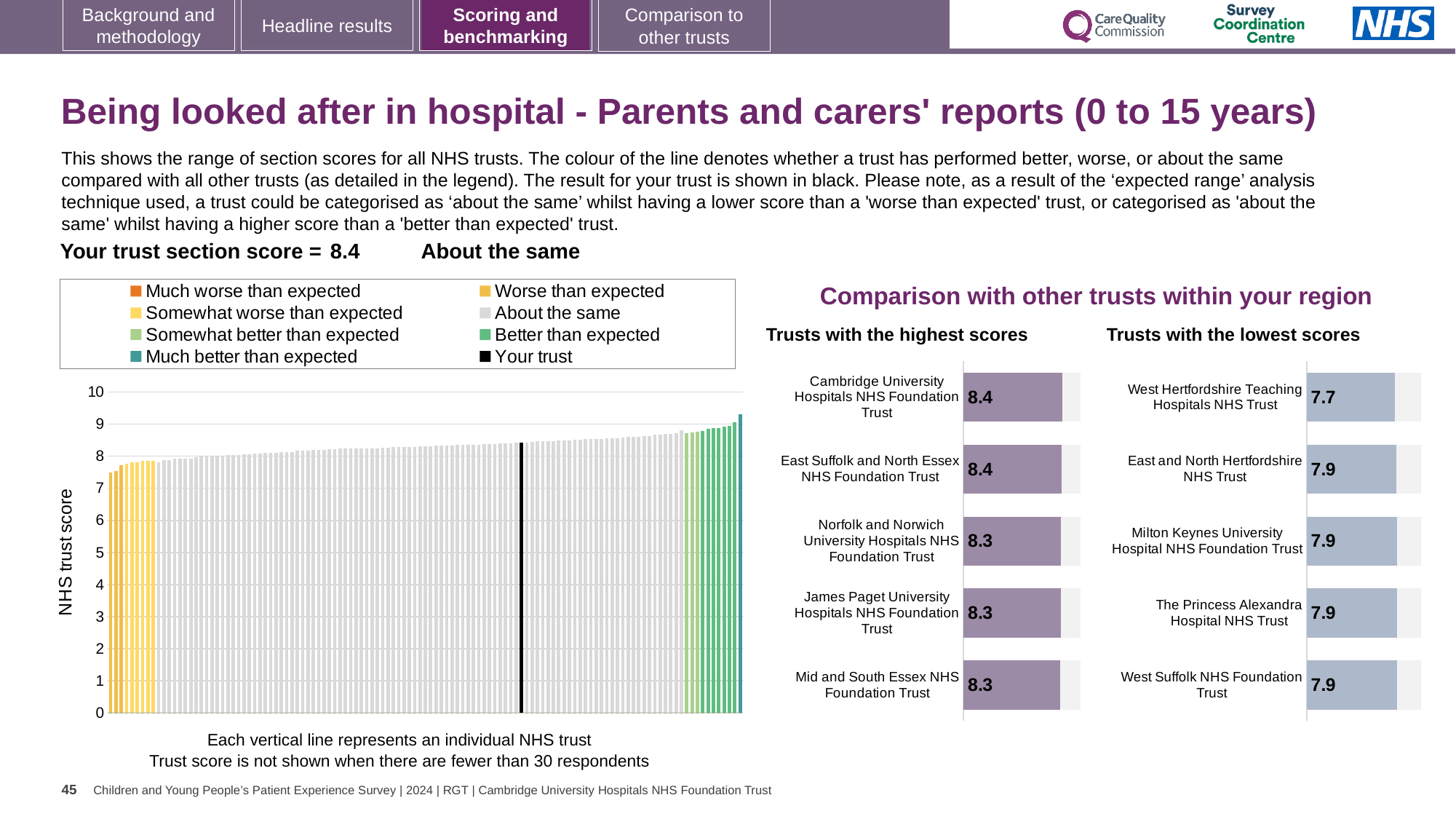
In the 'Trusts with the lowest scores' chart, what is the difference between the score for West Suffolk NHS Foundation Trust and the score for West Hertfordshire Teaching Hospitals NHS Trust? 0.2 In the 'Trusts with the lowest scores' chart, which trust has the lowest score? West Hertfordshire Teaching Hospitals NHS Trust Which is larger: the score for Cambridge University Hospitals NHS Foundation Trust in the 'Trusts with the highest scores' chart, or the score for West Hertfordshire Teaching Hospitals NHS Trust in the 'Trusts with the lowest scores' chart? Cambridge University Hospitals NHS Foundation Trust In the 'Trusts with the lowest scores' chart, what is the score for West Hertfordshire Teaching Hospitals NHS Trust? 7.7 What type of chart is the large chart on the left showing all NHS trusts? bar chart In the 'Trusts with the highest scores' chart, what is the score for Cambridge University Hospitals NHS Foundation Trust? 8.4 In the large chart on the left showing all NHS trusts, is the value for the black bar (your trust) greater or less than 8? greater How many trusts are listed in the 'Trusts with the highest scores' chart? 5 How many entries does the legend of the large chart on the left list? 8 In the 'Trusts with the highest scores' chart, what is the difference between the score for East Suffolk and North Essex NHS Foundation Trust and the score for Mid and South Essex NHS Foundation Trust? 0.1 In the large chart on the left showing all NHS trusts, do the bar values rise or fall from left to right? rise In the 'Trusts with the highest scores' chart, what is the score for Norfolk and Norwich University Hospitals NHS Foundation Trust? 8.3